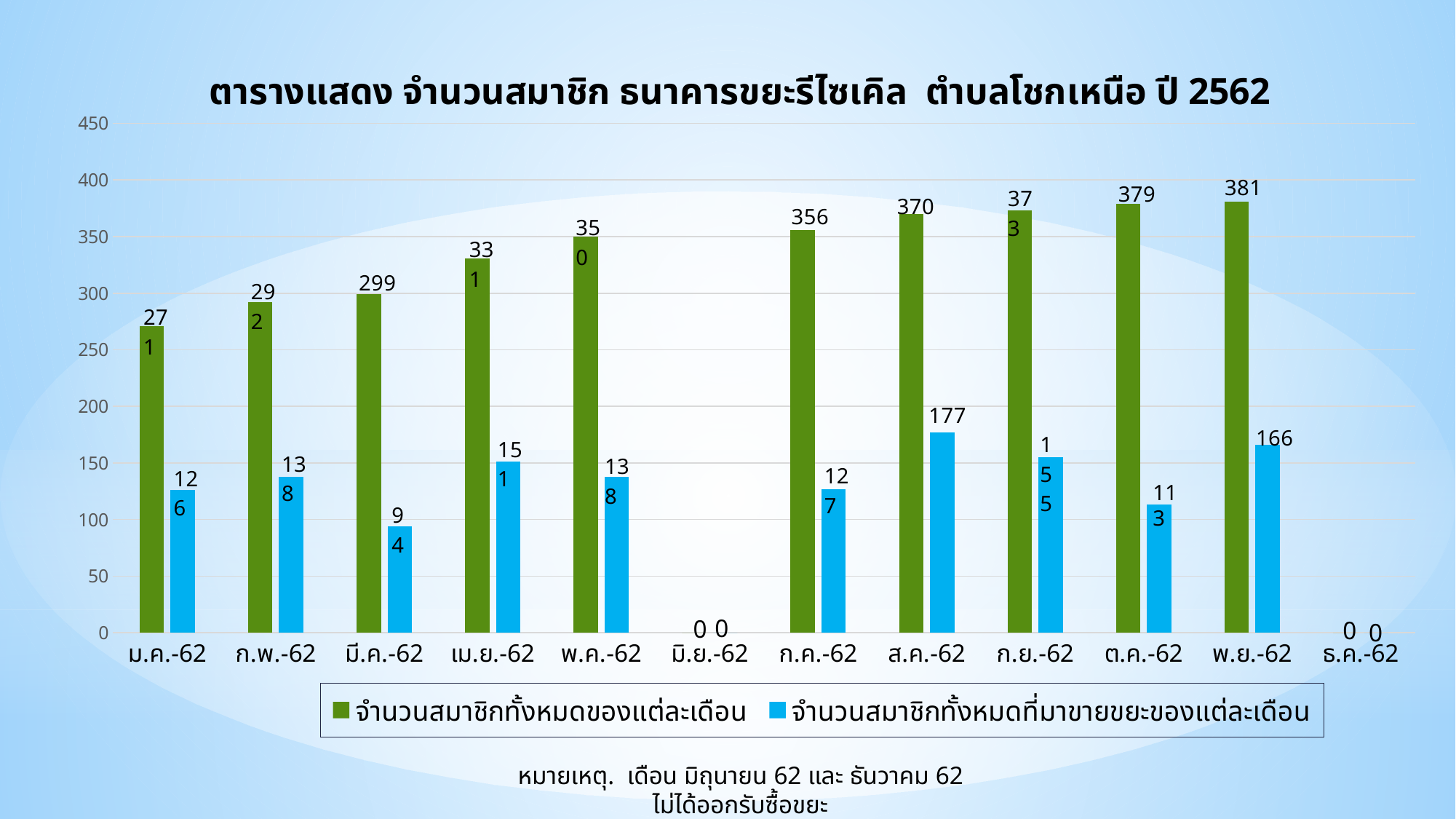
What is the value of จำนวนสมาชิกทั้งหมดที่มาขายขยะของแต่ละเดือน for มิ.ย.-62? 0 How many series does the legend list? 2 What is the value of จำนวนสมาชิกทั้งหมดของแต่ละเดือน for มี.ค.-62? 299 Is the value of จำนวนสมาชิกทั้งหมดที่มาขายขยะของแต่ละเดือน for มี.ค.-62 greater or less than 100? less What is the difference between the จำนวนสมาชิกทั้งหมดของแต่ละเดือน values for ต.ค.-62 and ก.ค.-62? 23 Which month has the highest value for จำนวนสมาชิกทั้งหมดของแต่ละเดือน? พ.ย.-62 Which is larger for จำนวนสมาชิกทั้งหมดของแต่ละเดือน: ส.ค.-62 or ก.ค.-62? ส.ค.-62 How many months are shown on the x axis? 12 What is the value of จำนวนสมาชิกทั้งหมดที่มาขายขยะของแต่ละเดือน for ส.ค.-62? 177 What is the value of จำนวนสมาชิกทั้งหมดของแต่ละเดือน for พ.ย.-62? 381 What is the difference between the จำนวนสมาชิกทั้งหมดที่มาขายขยะของแต่ละเดือน values for ส.ค.-62 and พ.ย.-62? 11 Which month has the highest value for จำนวนสมาชิกทั้งหมดที่มาขายขยะของแต่ละเดือน? ส.ค.-62